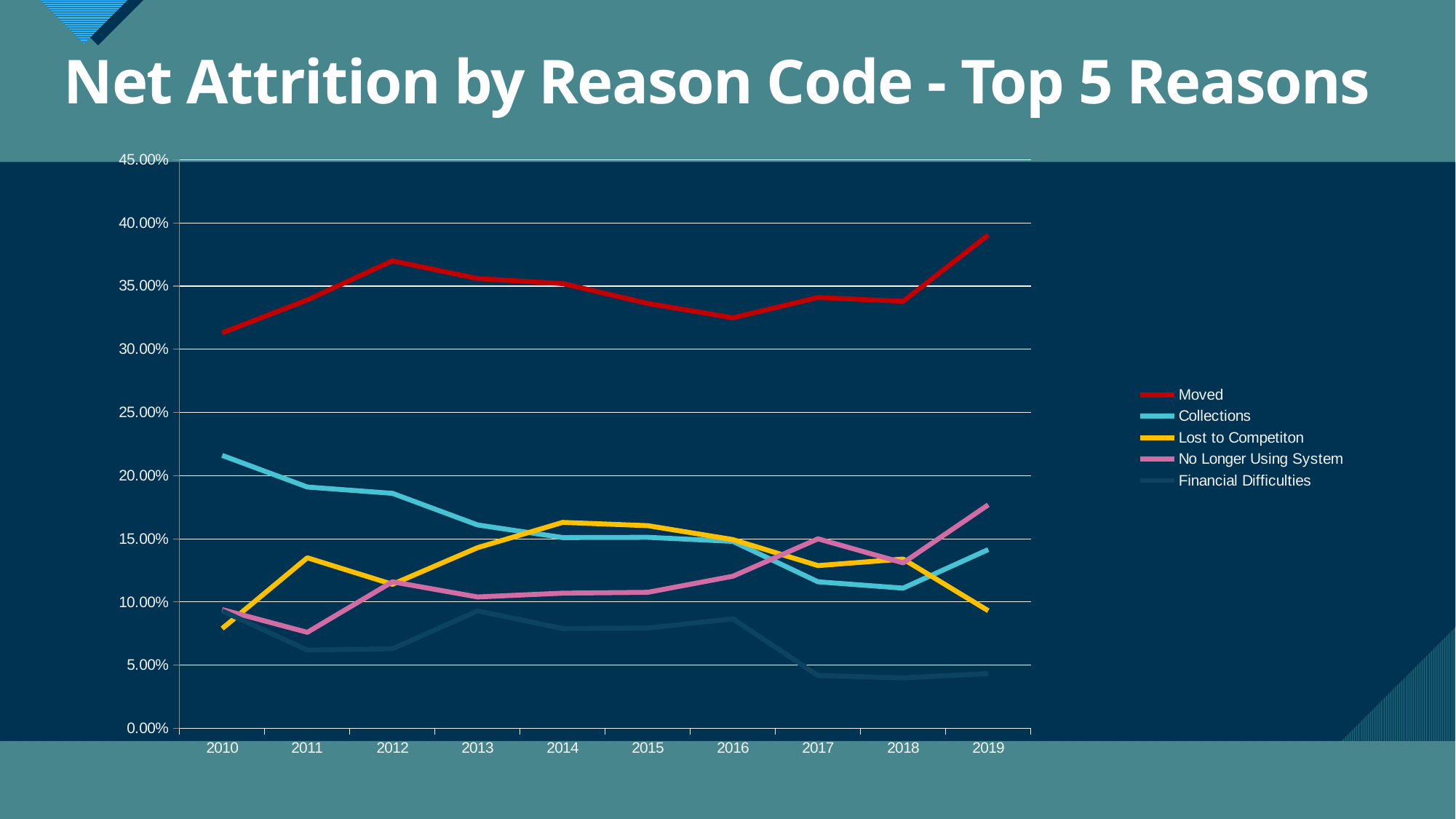
Is the value for Collections in 2010 greater or less than 20.00%? greater How many series does the legend list? 5 Is the value for Moved in 2019 greater or less than 35.00%? greater Which reason code has the highest net attrition in 2019? Moved Does the Collections line rise or fall from 2010 to 2018? fall How many years are shown on the x axis? 10 In 2019, which is larger: No Longer Using System or Lost to Competiton? No Longer Using System What kind of chart is shown on the slide? line chart What colour is the line for Moved? red Is the value for Financial Difficulties in 2018 greater or less than 5.00%? less In which year is the value for Moved highest? 2019 Which reason code has the lowest net attrition in 2019? Financial Difficulties